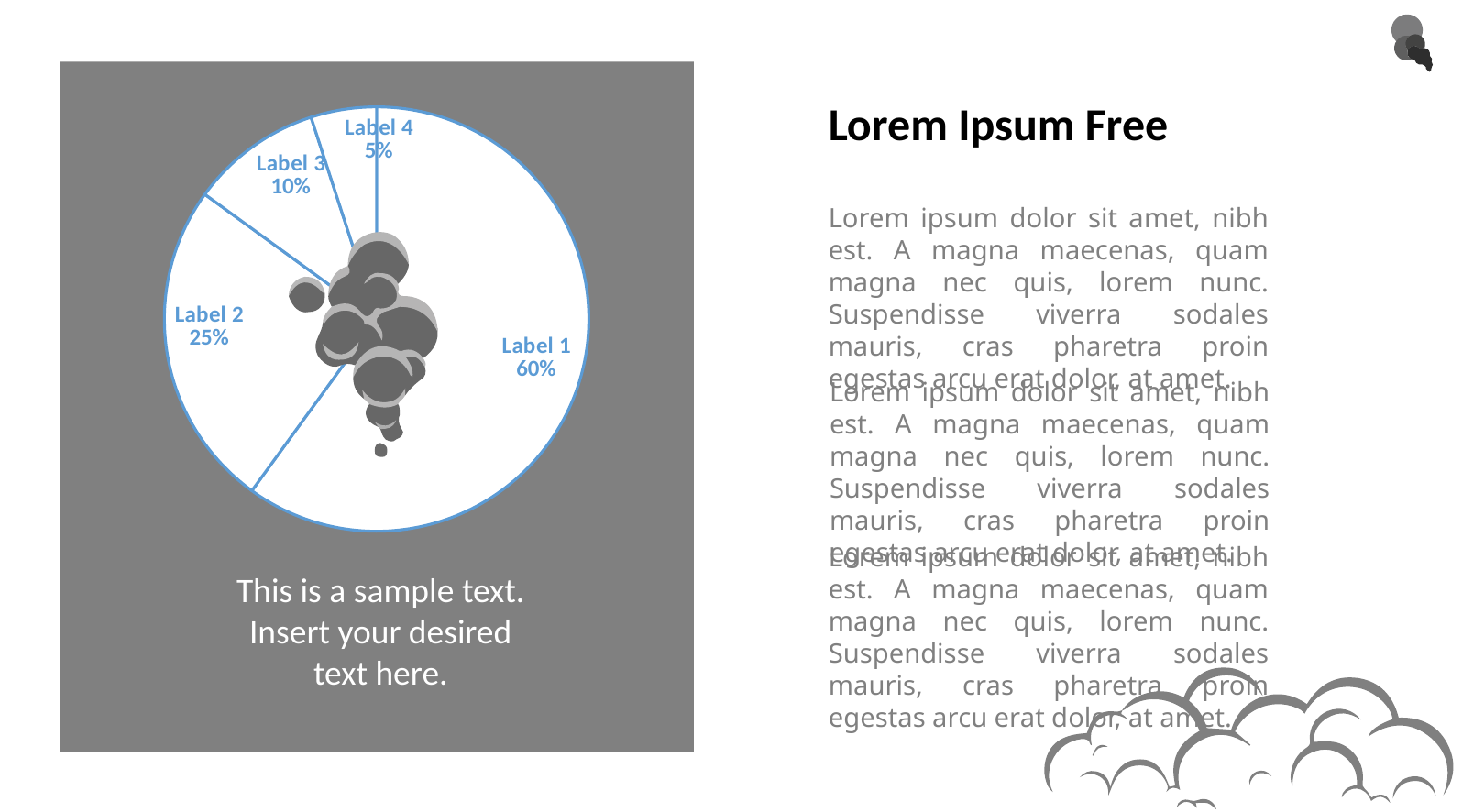
What is the combined value of Label 3 and Label 4? 15% Which is larger, the value for Label 3 or the value for Label 4? Label 3 What is the value for Label 3? 10% What is the value for Label 1? 60% What kind of chart is shown on the slide? pie chart Which slice of the pie chart is the smallest? Label 4 What is the value for Label 2? 25% What is the value for Label 4? 5% How many slices does the pie chart have? 4 Which slice of the pie chart is the largest? Label 1 What share of the pie does Label 2 represent? 25% What is the difference between the values for Label 1 and Label 2? 35%